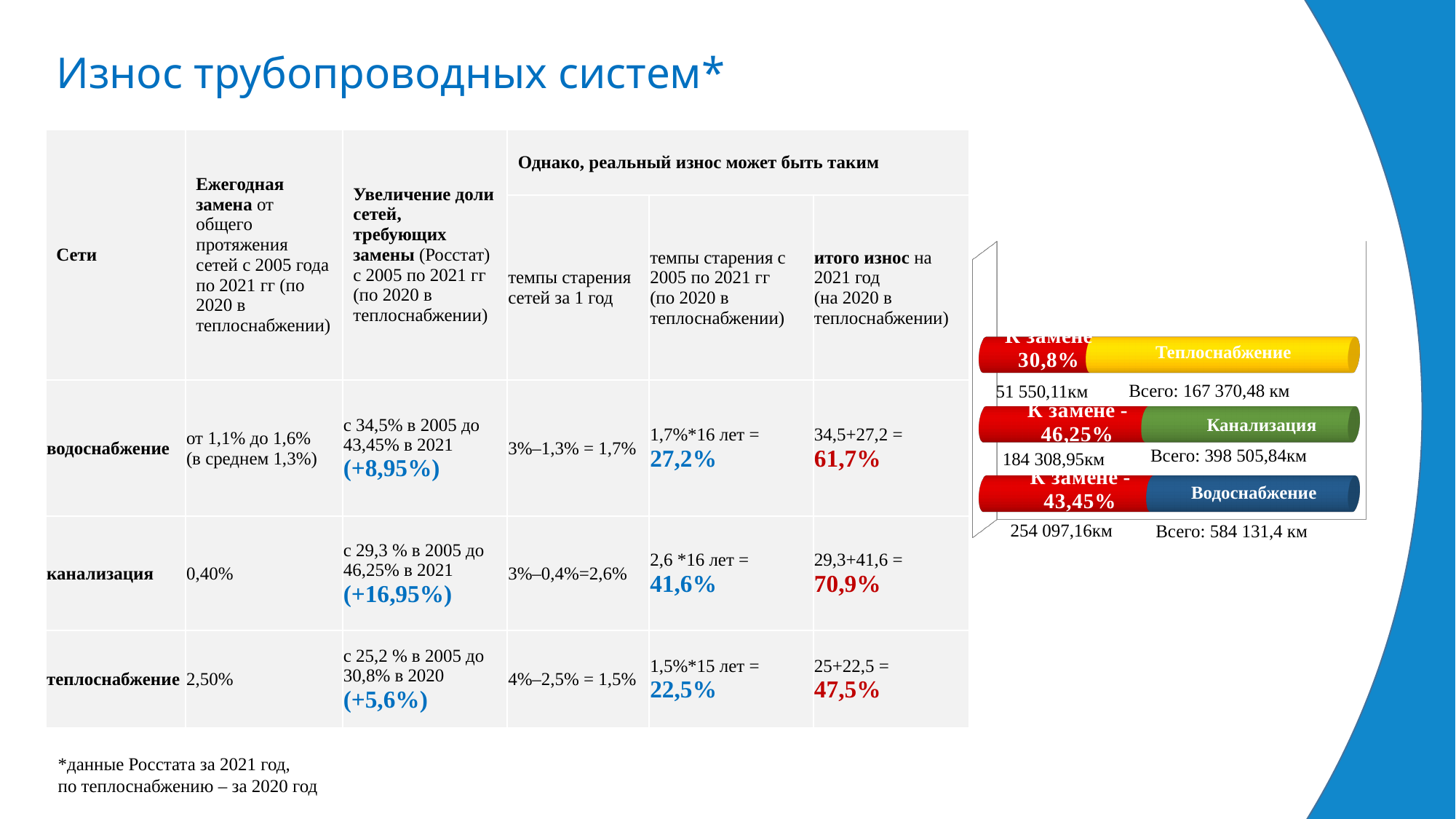
On the bar chart on the right, what is the total length ('Всего') of the Канализация network? 398 505,84км On the bar chart on the right, what share of the Водоснабжение network is marked 'К замене'? 43,45% On the bar chart on the right, which network has the greater total length: Канализация or Водоснабжение? Водоснабжение On the bar chart on the right, how many kilometres of the Водоснабжение network are to be replaced? 254 097,16км On the bar chart on the right, which network has the highest share marked 'К замене'? Канализация On the bar chart on the right, which network has the lowest share marked 'К замене'? Теплоснабжение On the bar chart on the right, what is the total length ('Всего') of the Водоснабжение network? 584 131,4 км On the bar chart on the right, what colour is the Канализация bar segment? Green On the bar chart on the right, what is the total length ('Всего') of the Теплоснабжение network? 167 370,48 км How many networks (bars) are shown on the bar chart on the right? 3 On the bar chart on the right, what share of the Канализация network is marked 'К замене'? 46,25% On the bar chart on the right, what share of the Теплоснабжение network is marked 'К замене'? 30,8%